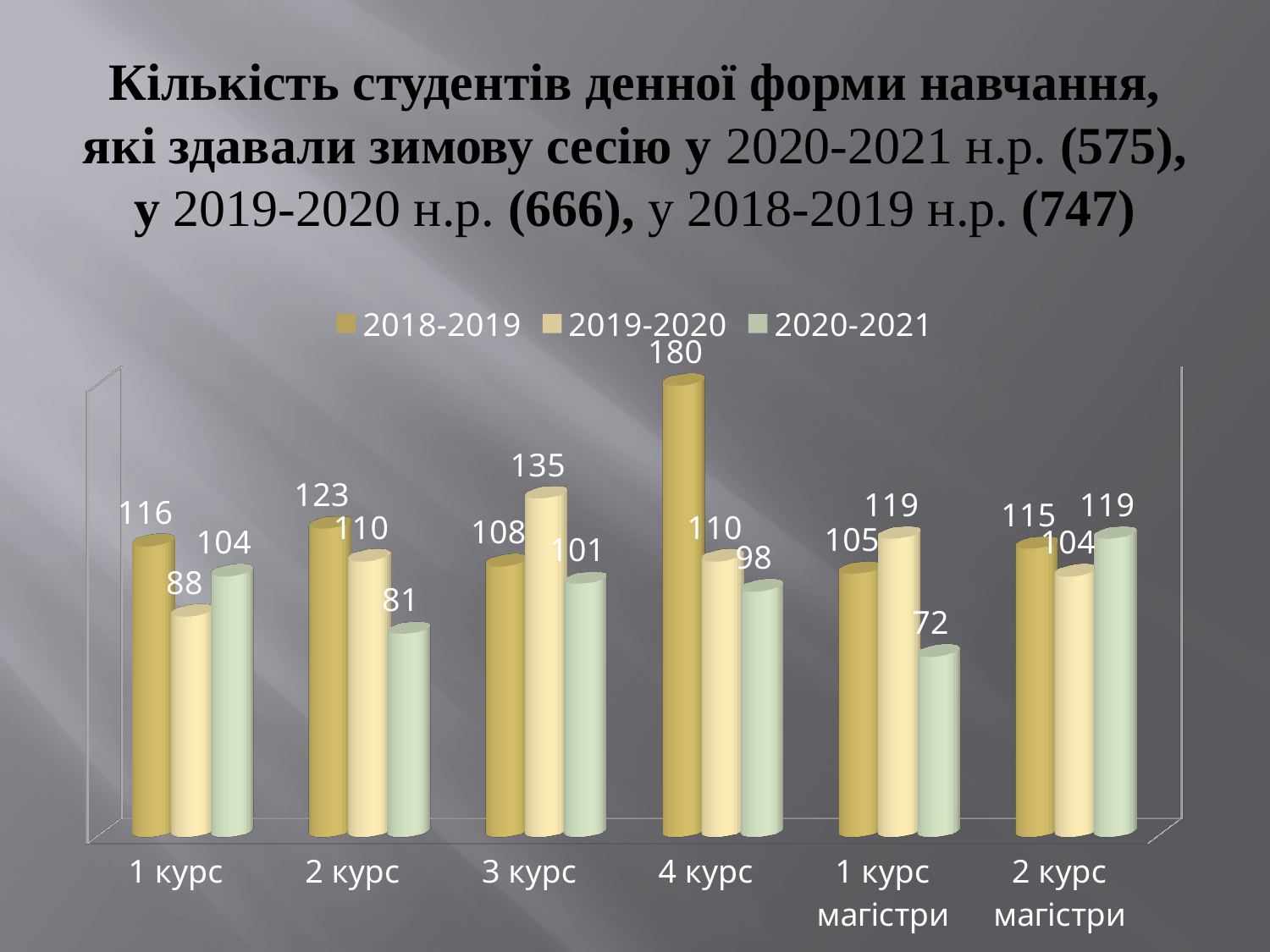
Which series is listed first in the legend? 2018-2019 What is the difference between the 2018-2019 and 2019-2020 values in the 1 курс category? 28 Which series has the lowest value in the 2 курс category? 2020-2021 Which is larger in the 2 курс магістри category: the 2018-2019 value or the 2020-2021 value? 2020-2021 What is the value for 2020-2021 in the 1 курс магістри category? 72 What is the value for 2019-2020 in the 3 курс category? 135 How many series does the legend list? 3 How many categories are shown on the x axis? 6 Which category has the highest value for the 2018-2019 series? 4 курс What type of chart is shown on the slide? bar chart What is the value for 2018-2019 in the 4 курс category? 180 Which category has the lowest value for the 2020-2021 series? 1 курс магістри